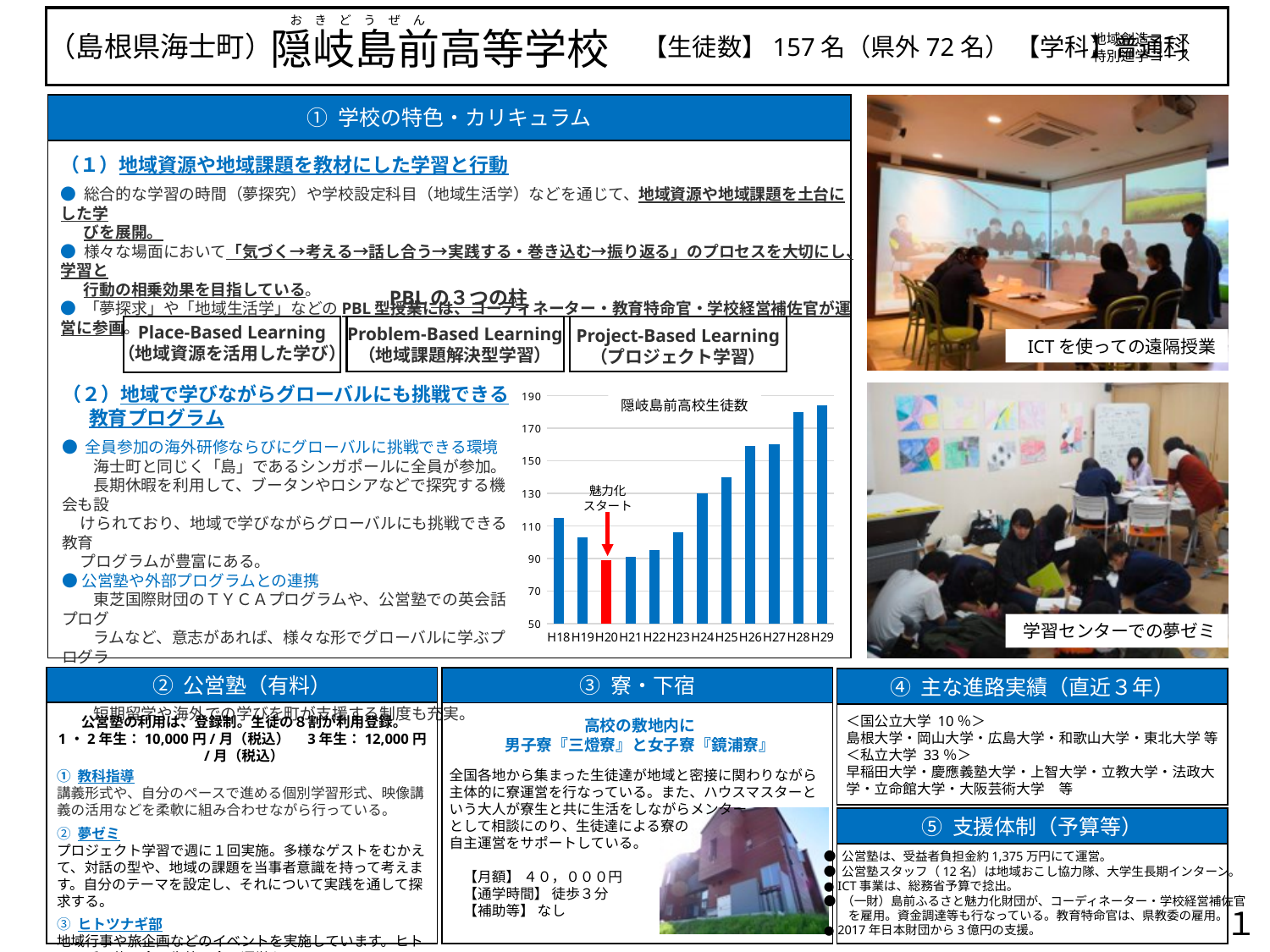
In the 隠岐島前高校生徒数 chart, is the value for H20 greater or less than 110? less In the 隠岐島前高校生徒数 chart, which is larger, the value for H29 or the value for H18? H29 What kind of chart is the 隠岐島前高校生徒数 chart? bar chart In the 隠岐島前高校生徒数 chart, which is larger, the value for H20 or the value for H24? H24 In the 隠岐島前高校生徒数 chart, is the value for H22 greater or less than 110? less Which bar in the 隠岐島前高校生徒数 chart is coloured red, and what annotation points to it? H20; 魅力化スタート In the 隠岐島前高校生徒数 chart, is the value for H24 greater or less than 110? greater In the 隠岐島前高校生徒数 chart, do the values rise or fall from H20 to H29? rise How many years (categories) are shown on the x axis of the 隠岐島前高校生徒数 chart? 12 What is the title of the bar chart on the slide? 隠岐島前高校生徒数